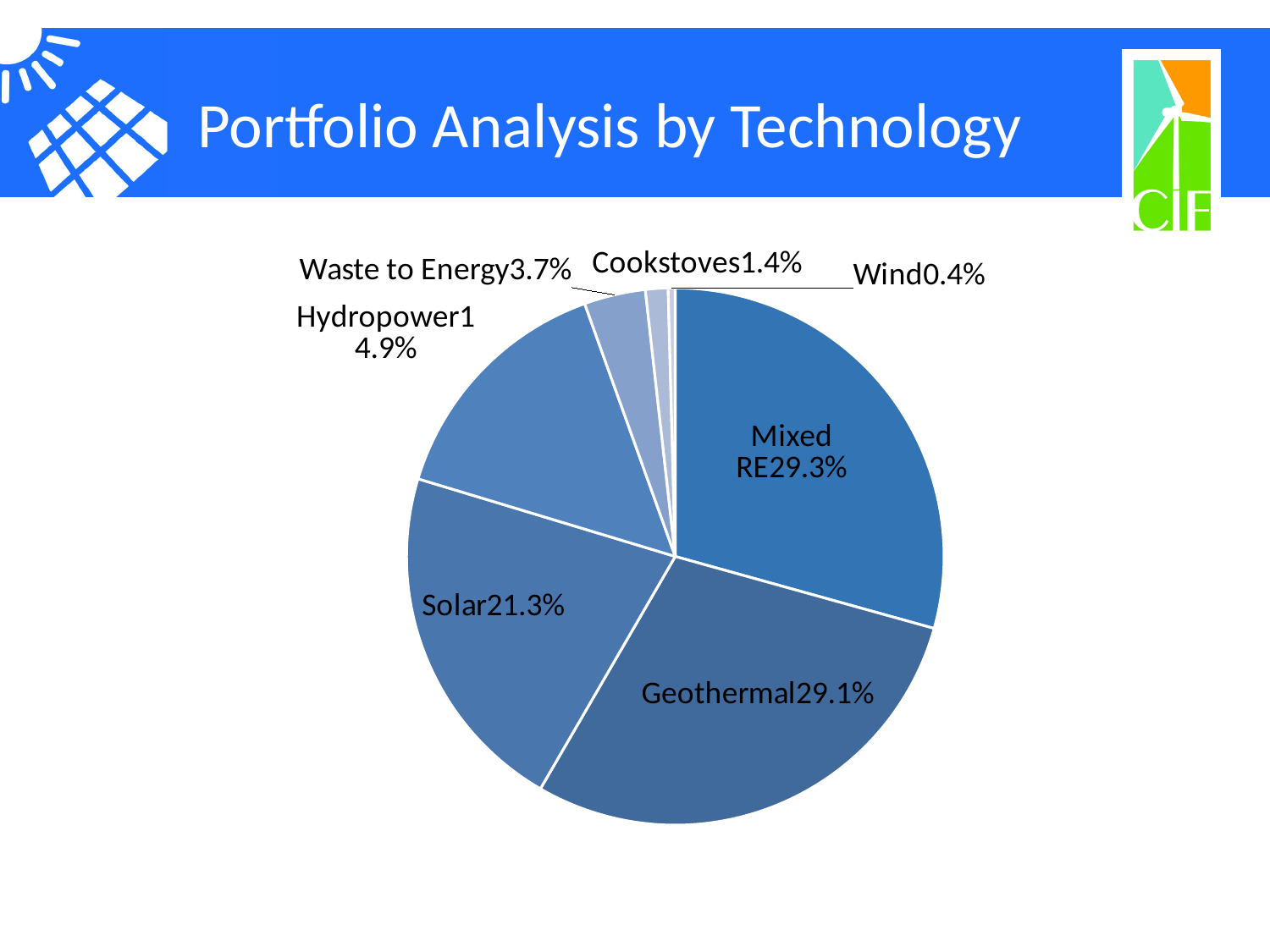
What share is labelled for Hydropower? 14.9% What type of chart is shown on the slide? Pie chart Which technology has the largest slice of the pie? Mixed RE Which technology has the smallest slice of the pie? Wind How many technology categories are shown in the pie chart? 7 What percentage is shown for Waste to Energy? 3.7% What percentage is shown for Geothermal? 29.1% Which has a larger share, Solar or Hydropower? Solar What share of the pie does Solar represent? 21.3% How many percentage points larger is Solar's share than Hydropower's share? 6.4 What share of the pie is Cookstoves? 1.4% How many percentage points larger is Geothermal's share than Solar's share? 7.8